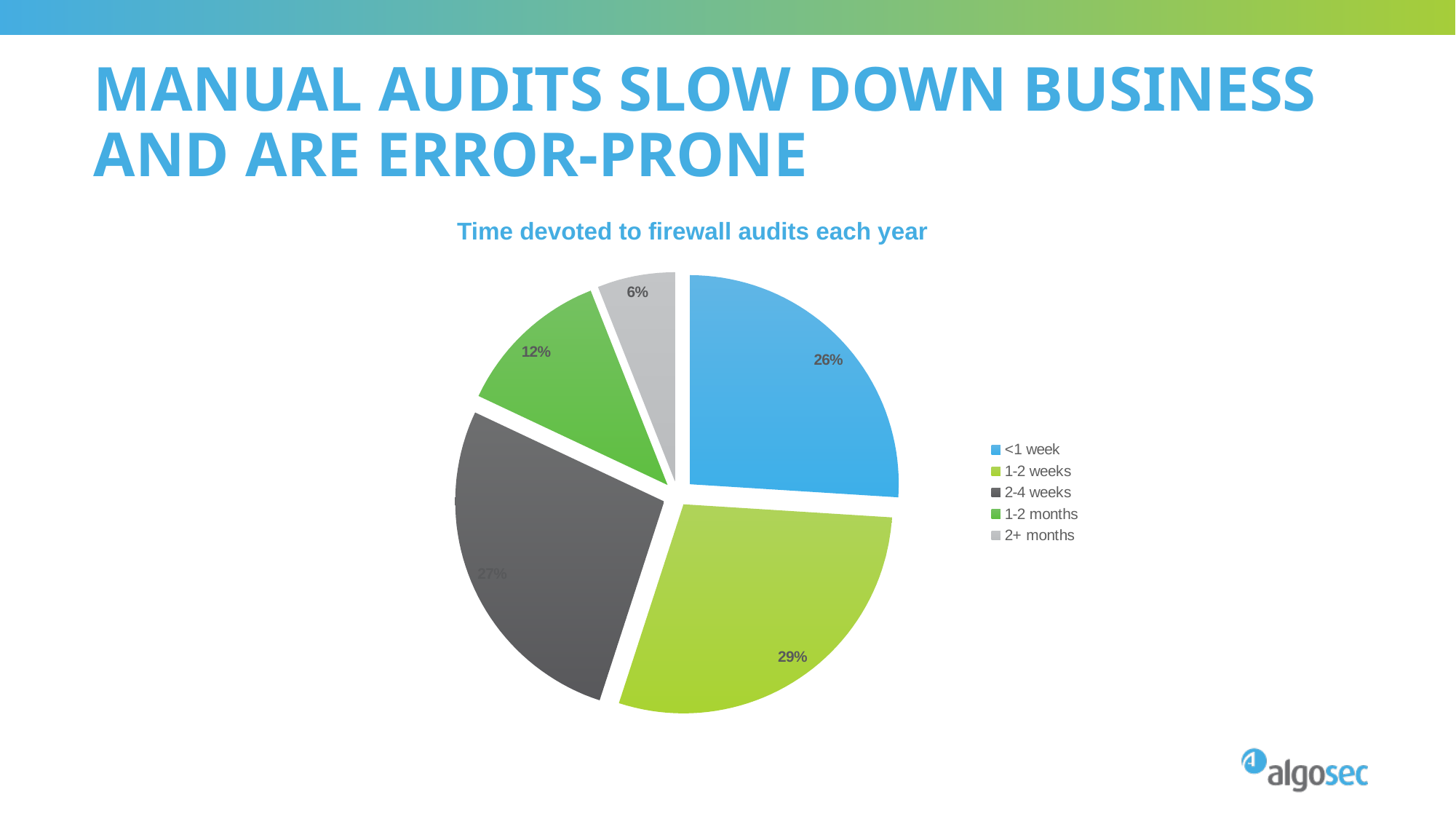
What percentage is shown for the 2+ months slice? 6% What is the title of the chart? Time devoted to firewall audits each year Which category has the largest share of the pie? 1-2 weeks What percentage of respondents devote less than 1 week to firewall audits each year? 26% What percentage is shown for the 1-2 weeks slice? 29% What kind of chart is shown on the slide? Pie chart What percentage is shown for the 2-4 weeks slice? 27% What is the difference in percentage points between the 1-2 months slice and the 2+ months slice? 6 What percentage is shown for the 1-2 months slice? 12% Which is larger, the share for <1 week or the share for 1-2 months? <1 week How many categories does the legend list? 5 Which category has the smallest share of the pie? 2+ months